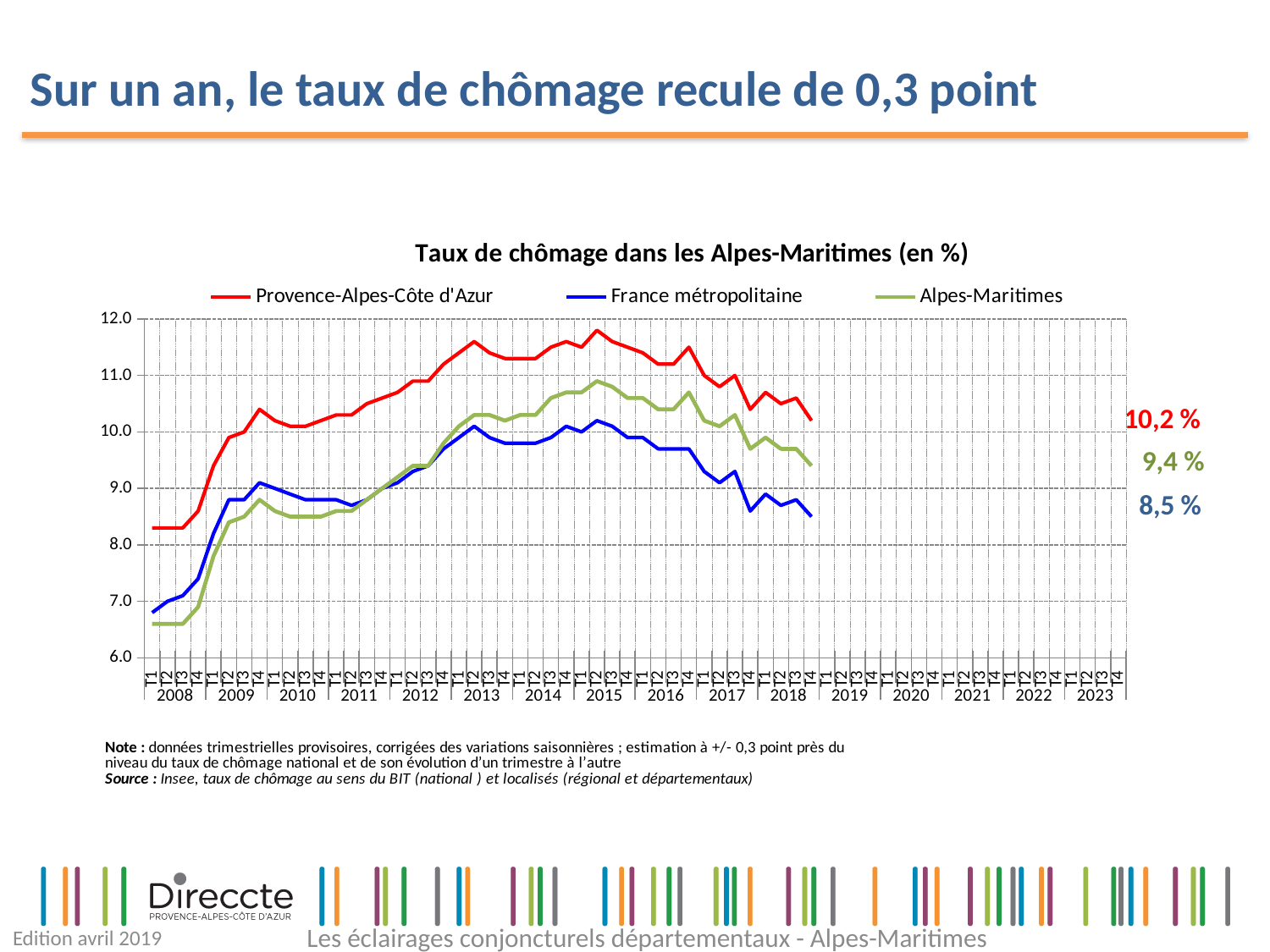
Do the values for all three series rise or fall between 2017 and the end of 2018? fall What is the difference between the latest values for Provence-Alpes-Côte d'Azur and France métropolitaine? 1,7 points What is the title of the chart? Taux de chômage dans les Alpes-Maritimes (en %) What is the latest value shown for Alpes-Maritimes? 9,4 % At the end of the plotted period, which is larger: the value for Alpes-Maritimes or for France métropolitaine? Alpes-Maritimes What is the latest value shown for Provence-Alpes-Côte d'Azur? 10,2 % Which series has the lowest value at the end of the plotted period? France métropolitaine Is the value for Alpes-Maritimes in T1 2008 greater or less than 7.0? less What type of chart is shown on the slide? line chart How many series does the chart legend list? 3 What is the latest value shown for France métropolitaine? 8,5 % Which series has the highest value at the end of the plotted period? Provence-Alpes-Côte d'Azur